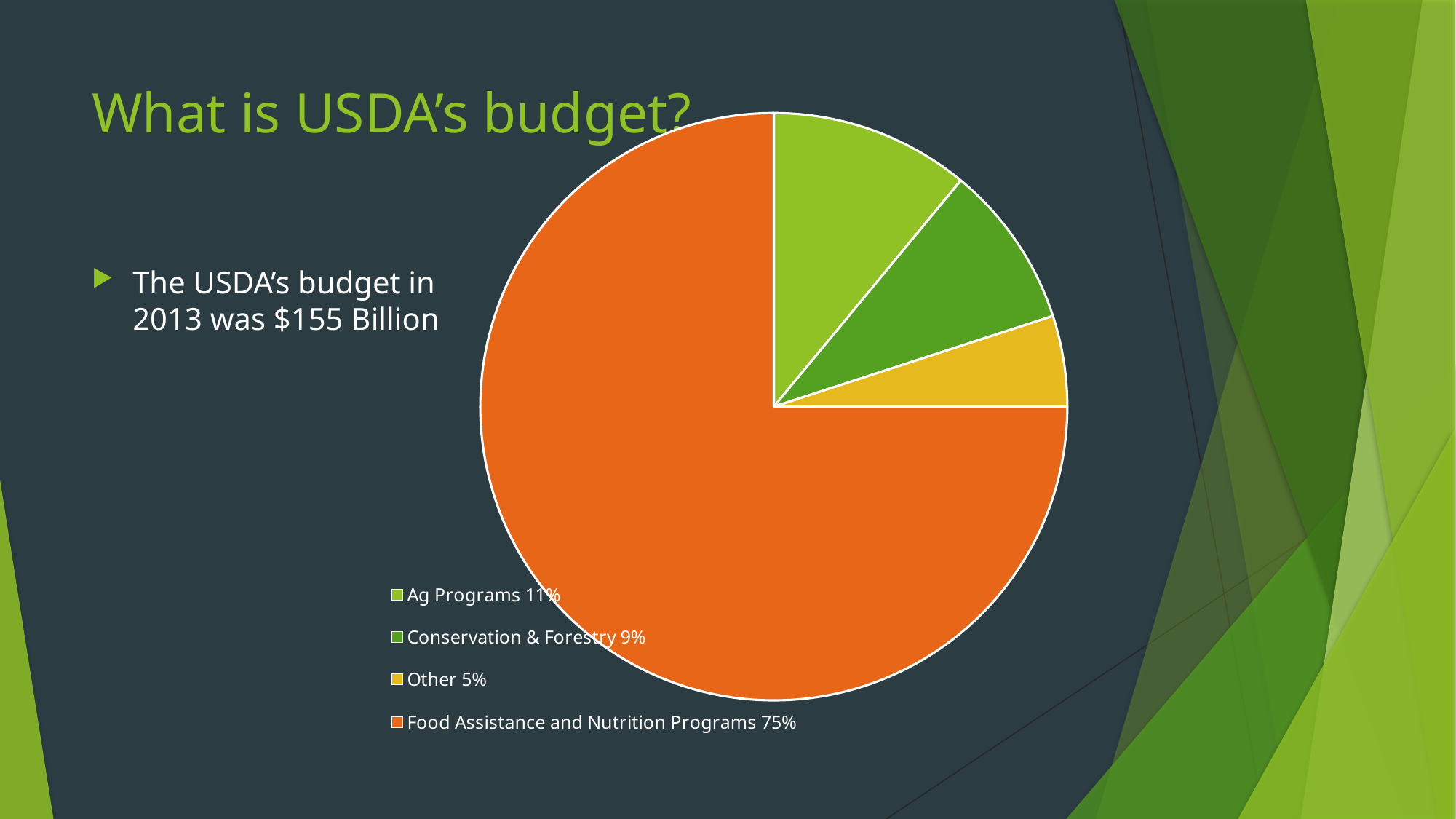
What colour is the slice for Food Assistance and Nutrition Programs? orange How many slices does the pie chart have? 4 What share of the pie does Conservation & Forestry represent? 9% How many entries does the legend list? 4 What share of the pie does Food Assistance and Nutrition Programs represent? 75% What is the difference in percentage points between Ag Programs and Conservation & Forestry? 2 What share of the pie does Ag Programs represent? 11% Which category has the largest slice of the pie? Food Assistance and Nutrition Programs Which category has the smallest slice of the pie? Other Which is larger, the slice for Ag Programs or the slice for Other? Ag Programs What kind of chart is shown on the slide? pie chart